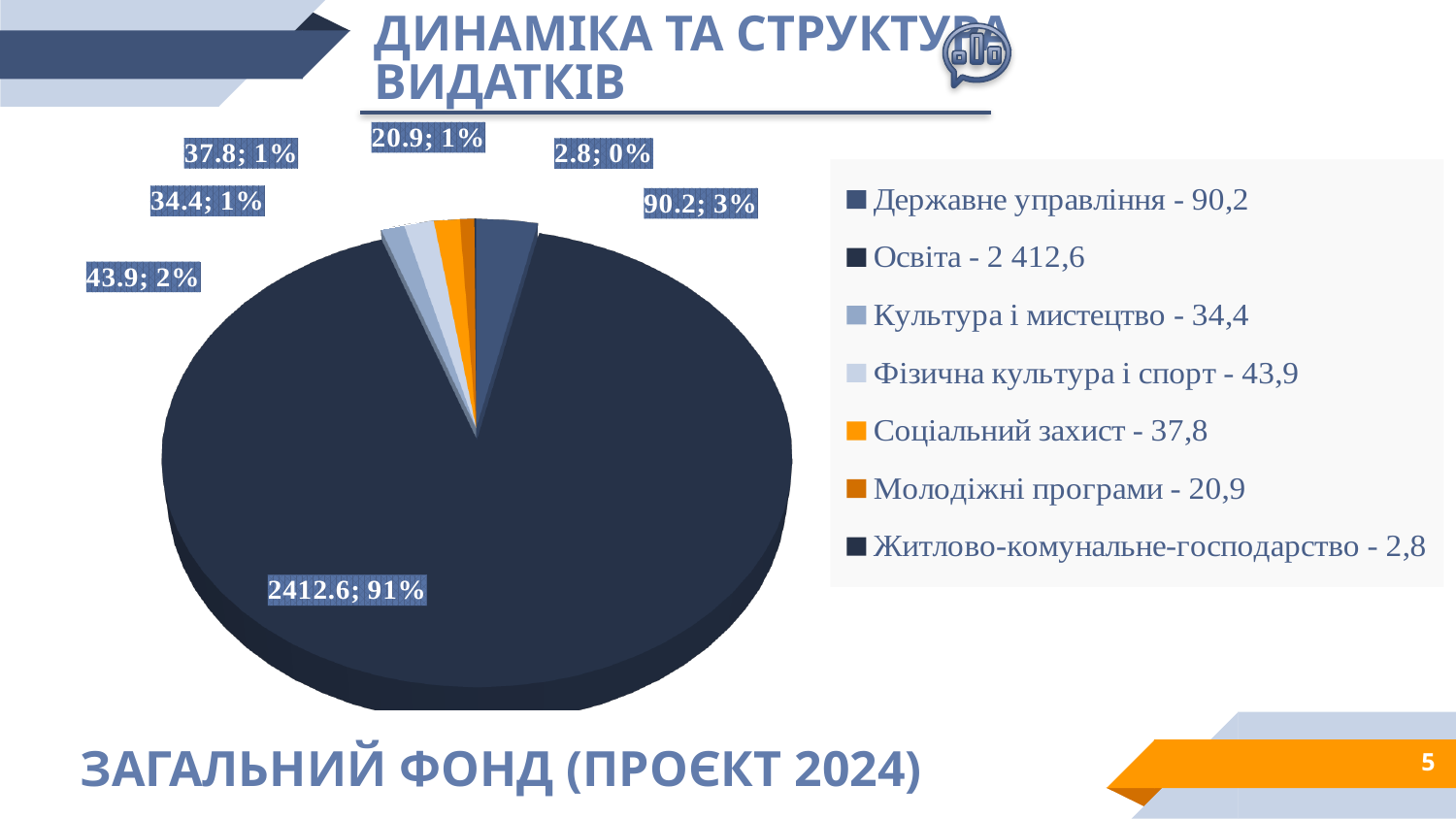
What share of the pie does Державне управління account for? 3% Which category has the largest slice of the pie chart? Освіта Which category has the smallest slice of the pie chart? Житлово-комунальне-господарство What is the title of the slide containing the pie chart? ДИНАМІКА ТА СТРУКТУРА ВИДАТКІВ What kind of chart is shown on the slide? Pie chart What is the value for Державне управління? 90.2 Which is larger, Фізична культура і спорт or Соціальний захист? Фізична культура і спорт What is the value for Освіта? 2412.6 What is the difference between the values for Фізична культура і спорт and Соціальний захист? 6.1 What share of the pie does Освіта account for? 91% How many categories does the pie chart have? 7 What is the value for Молодіжні програми? 20.9